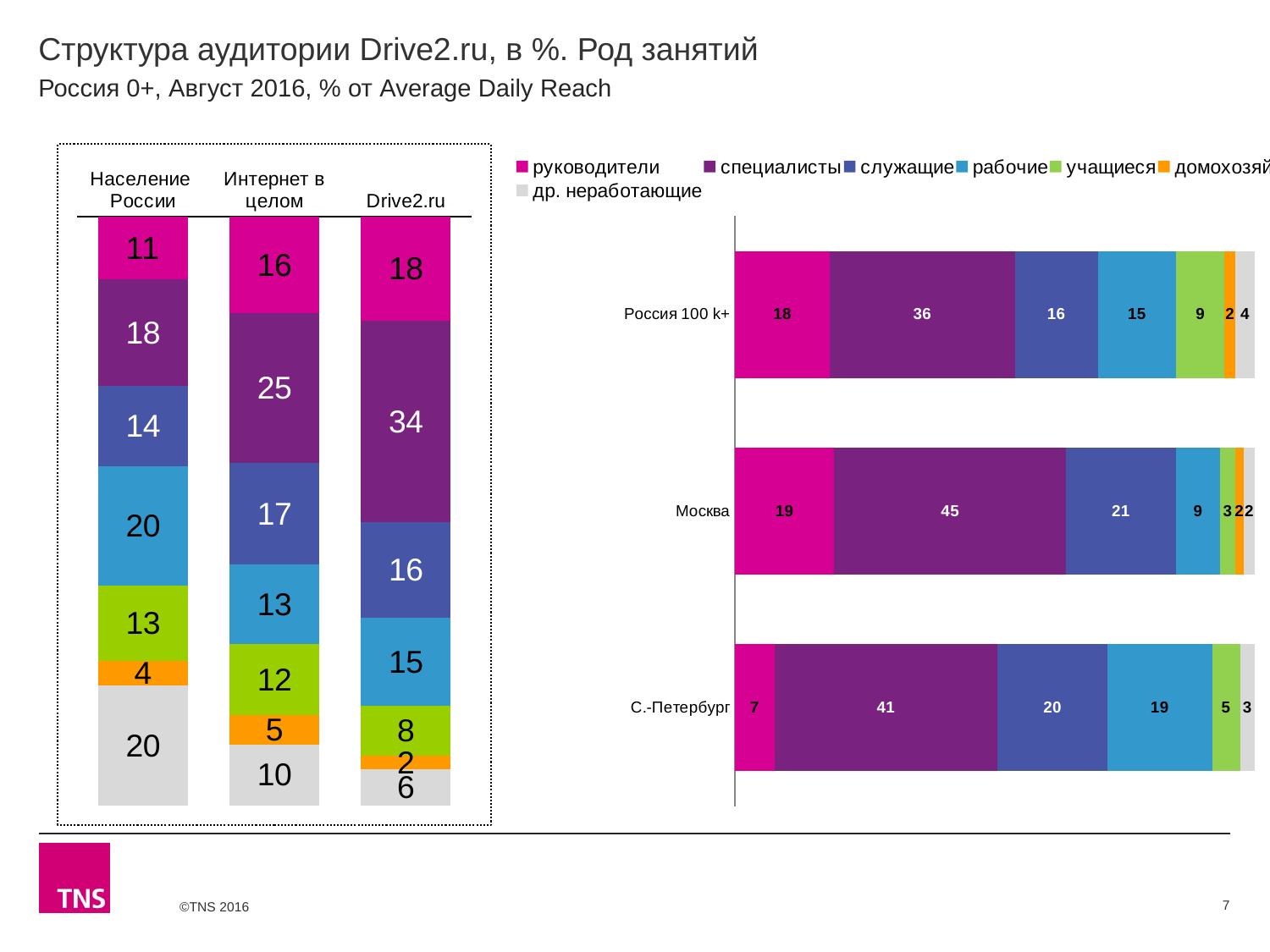
In the left chart, is the рабочие value larger for Население России or for Drive2.ru? Население России In the right chart, which region has the lowest руководители value? С.-Петербург In the left chart, what is the difference between the специалисты values for Drive2.ru and Население России? 16 In the right chart, what is the value of the специалисты segment for Москва? 45 How many series does the legend list? 7 In the right chart, what is the value of the руководители segment for С.-Петербург? 7 In the left chart, what is the value of the руководители segment for Население России? 11 In the right chart, what is the difference between the рабочие values for С.-Петербург and Москва? 10 In the left chart, what is the value of the др. неработающие segment for Интернет в целом? 10 In the left chart, which of the three bars has the largest специалисты segment? Drive2.ru What type of chart is the right chart? Stacked bar chart In the left chart, what is the value of the специалисты segment for Drive2.ru? 34